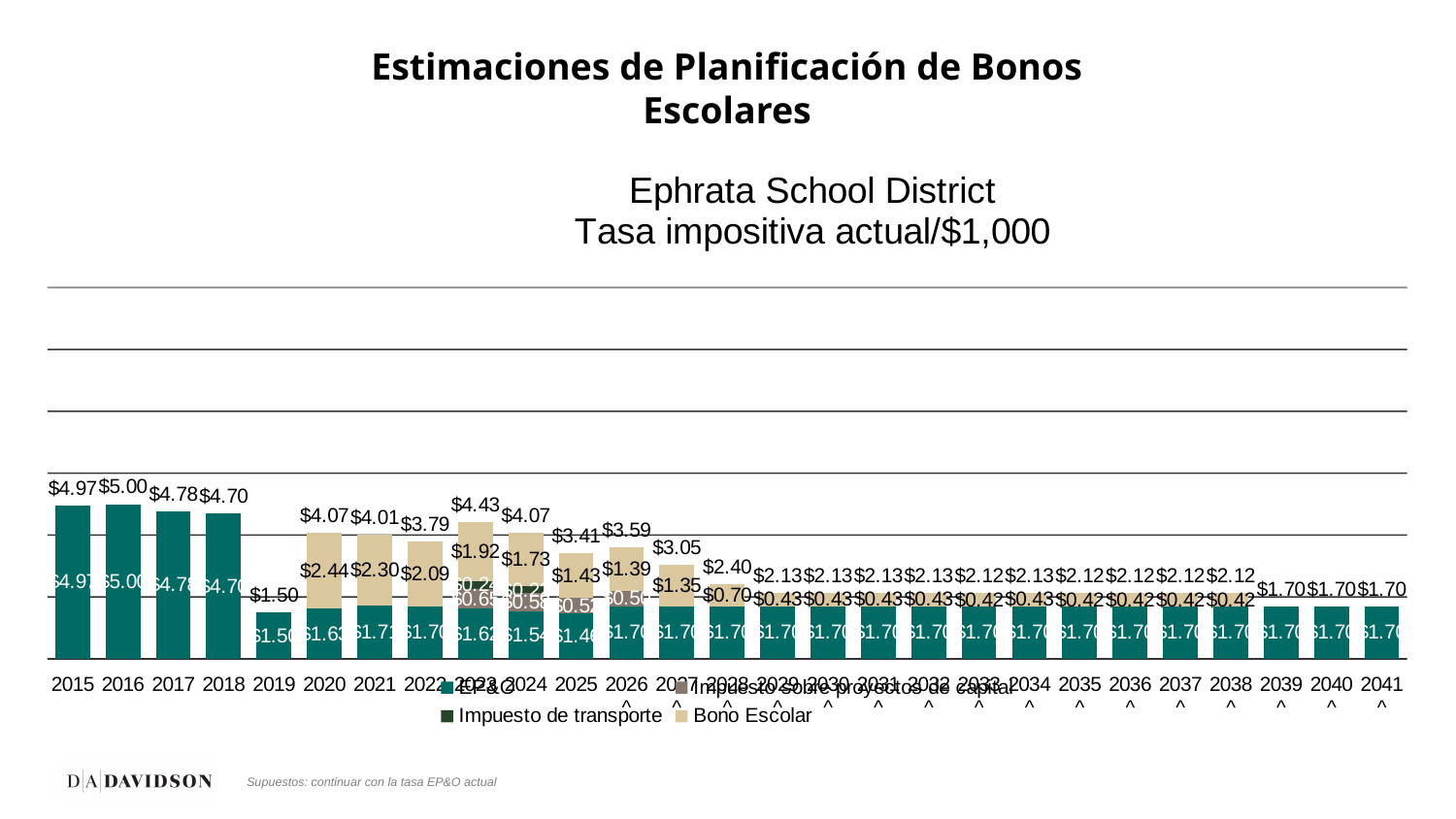
Which year has the highest total tax rate? 2016 What is the Bono Escolar value labeled for 2028? $0.70 What is the total tax rate labeled above the bar for 2016? $5.00 How many series does the chart legend list? 4 What kind of chart is shown on the slide? Bar chart Do the total tax rates generally rise or fall from 2029 to 2041? Fall Which year has a larger total tax rate, 2025 or 2026? 2026 Which year has the lowest total tax rate? 2019 How many years are shown along the x axis of the chart? 27 What is the difference between the total tax rate for 2020 and the total for 2022? $0.28 What is the Bono Escolar value labeled for 2020? $2.44 What is the total tax rate labeled above the bar for 2023? $4.43